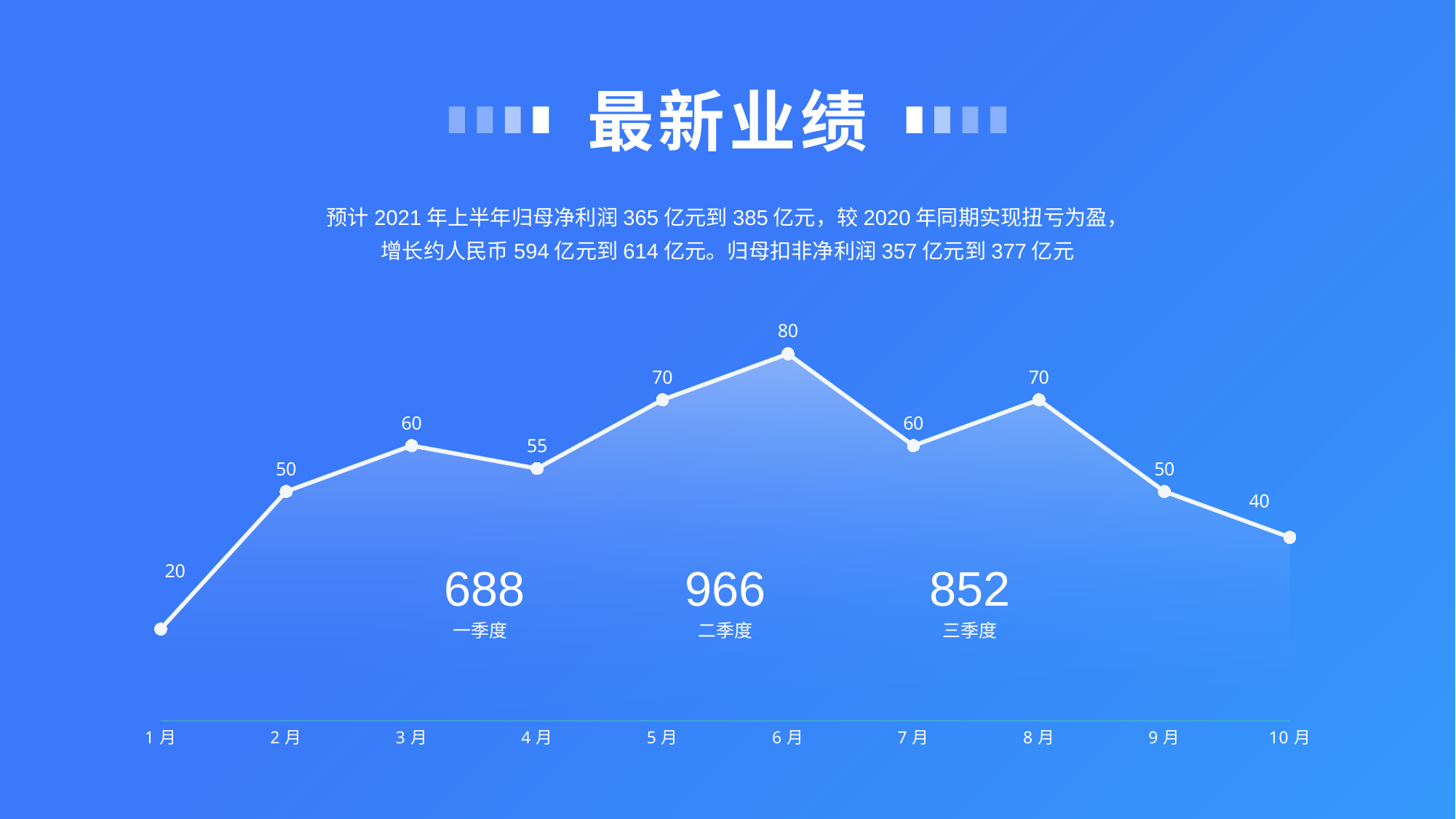
How many months are plotted on the chart? 10 What kind of chart is shown on the slide? line chart What is the difference between the values for 2月 and 1月? 30 What is the value for 6月? 80 Which is larger, the value for 5月 or the value for 7月? 5月 What is the title of the slide containing the chart? 最新业绩 Which month has the highest value? 6月 What is the value for 4月? 55 Which month has the lowest value? 1月 Do the values rise or fall from 8月 to 10月? fall What is the value for 1月? 20 What is the difference between the values for 6月 and 10月? 40